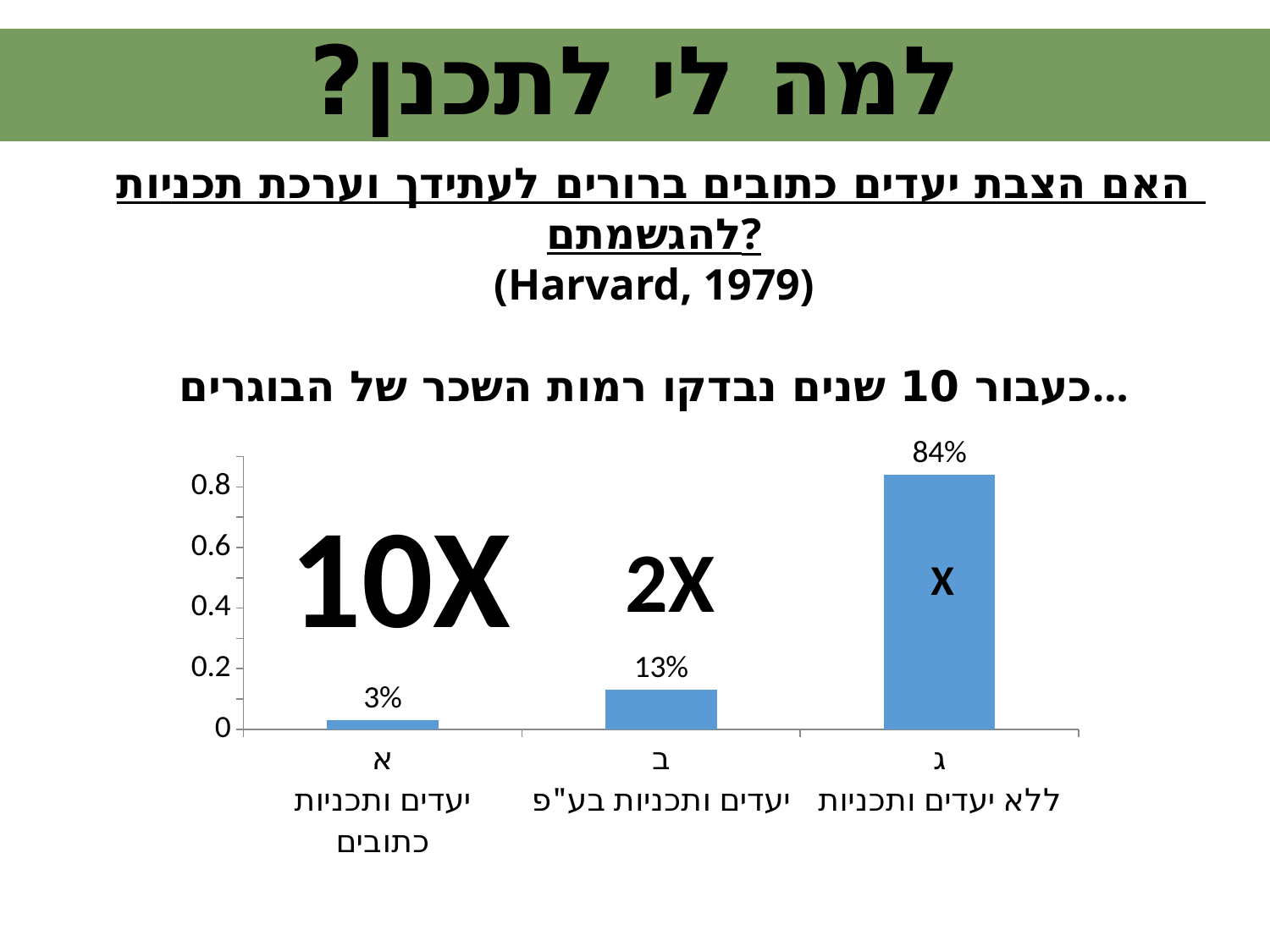
What is the difference between the values for category ג and category ב? 71% What kind of chart is shown on the slide? bar chart What multiplier label is printed above the bar for category א? 10X Which category has the lowest value? א (יעדים ותכניות כתובים) What value is shown for category ג (ללא יעדים ותכניות)? 84% How many categories are shown in the chart? 3 Which category has the highest value? ג (ללא יעדים ותכניות) Which is larger, the value for category ב or the value for category א? ב Is the value for category ג greater or less than 0.6 on the axis? greater What value is shown for category ב (יעדים ותכניות בע"פ)? 13% What is the difference between the values for category ב and category א? 10% What value is shown for category א (יעדים ותכניות כתובים)? 3%